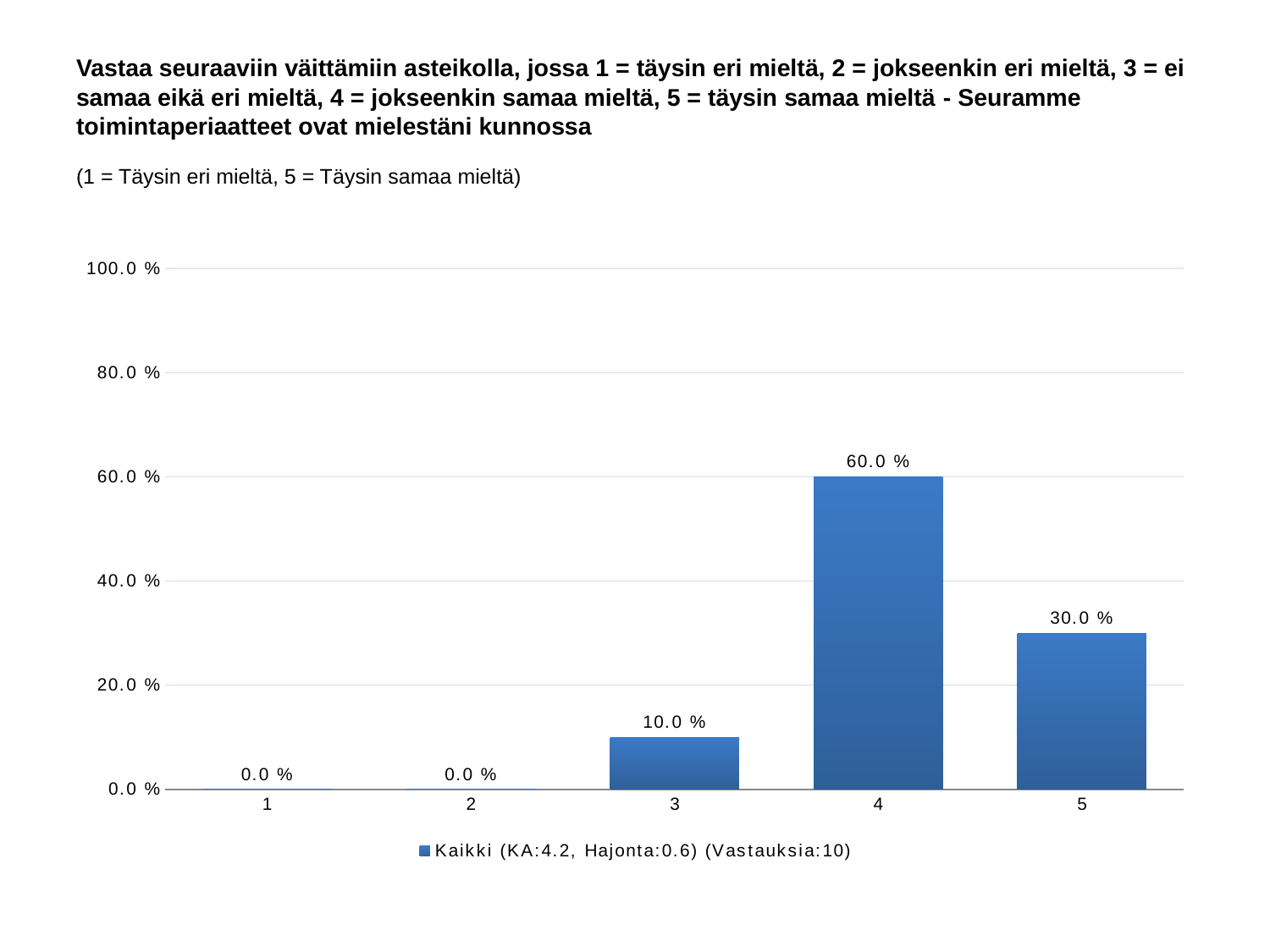
What is the legend entry for the series? Kaikki (KA:4.2, Hajonta:0.6) (Vastauksia:10) What is the value for category 1? 0.0 % What is the value for category 3? 10.0 % What is the value for category 4? 60.0 % What is the difference between the values for categories 4 and 5? 30.0 % Which category has the highest value? 4 Which is larger, the value for category 3 or the value for category 5? 5 What kind of chart is shown? bar chart Is the value for category 4 greater or less than 40.0 %? greater How many categories are shown on the x axis? 5 How many series does the legend list? 1 What is the value for category 5? 30.0 %